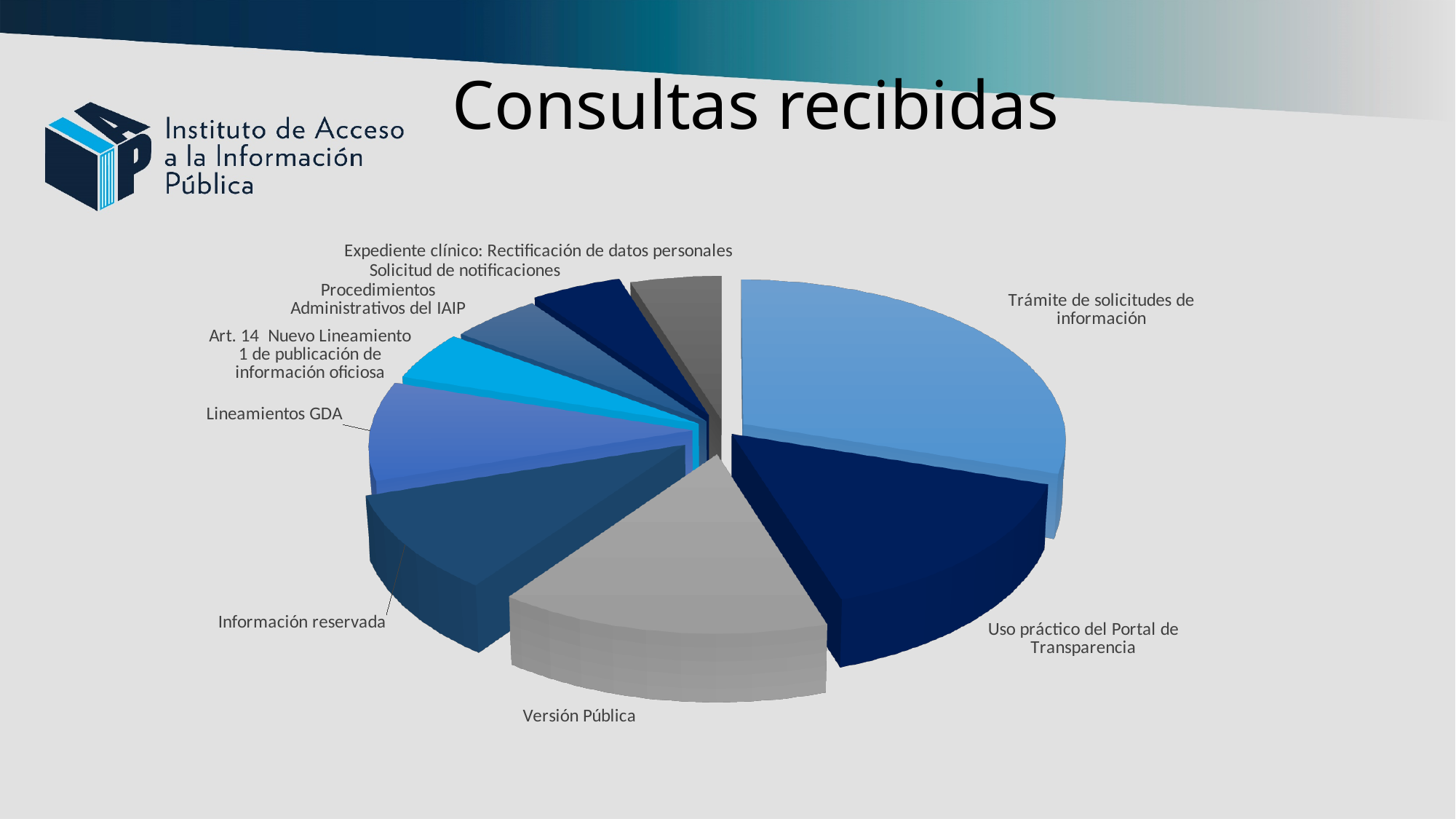
Which slice is larger: Trámite de solicitudes de información or Versión Pública? Trámite de solicitudes de información Which slice is larger: Información reservada or Solicitud de notificaciones? Información reservada What colour is the Versión Pública slice? Grey Which slice is larger: Versión Pública or Lineamientos GDA? Versión Pública How many categories (slices) does the pie chart have? 9 What is the title of the chart? Consultas recibidas What kind of chart is shown on the slide? Pie chart